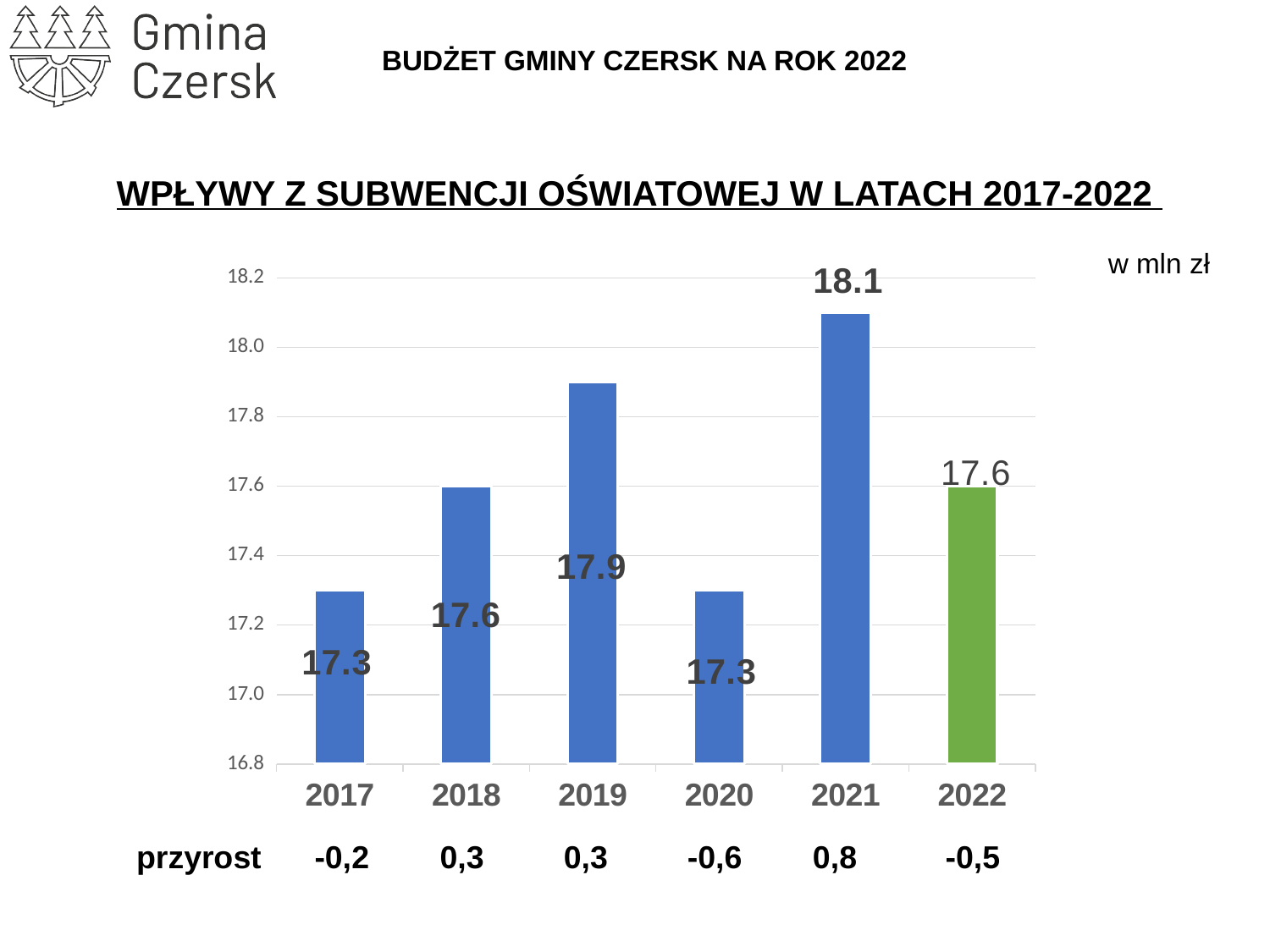
Which is larger, the value for 2019 or the value for 2022? 2019 What is the value for 2022? 17.6 How many years are shown on the x axis? 6 Is the value for 2021 greater or less than 18.0? greater Which year has the highest value? 2021 What is the difference between the values for 2019 and 2018? 0.3 What is the value for 2021? 18.1 Which bar is shown in green rather than blue? 2022 What is the value for 2019? 17.9 What is the difference between the values for 2021 and 2020? 0.8 What kind of chart is this? bar chart Do the values rise or fall from 2020 to 2021? rise